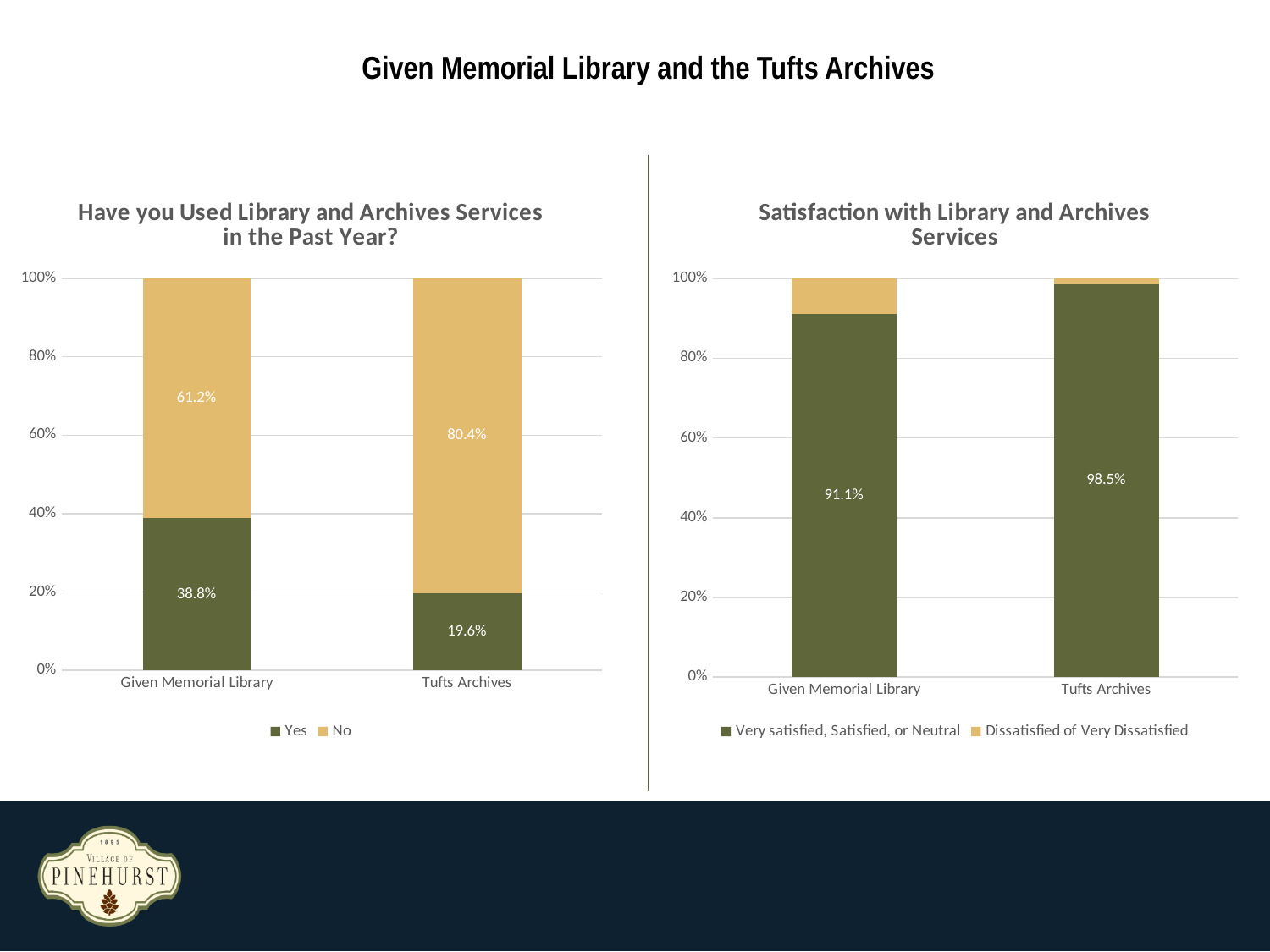
How many series does the legend of the 'Satisfaction with Library and Archives Services' chart list? 2 In the 'Have you Used Library and Archives Services in the Past Year?' chart, which category has the higher Yes value? Given Memorial Library In the 'Satisfaction with Library and Archives Services' chart, what is the difference between the 'Very satisfied, Satisfied, or Neutral' values for Tufts Archives and Given Memorial Library? 7.4% In the 'Have you Used Library and Archives Services in the Past Year?' chart, what is the difference between the Yes values for Given Memorial Library and Tufts Archives? 19.2% How many categories are shown on the x axis of the 'Have you Used Library and Archives Services in the Past Year?' chart? 2 In the 'Satisfaction with Library and Archives Services' chart, is the 'Dissatisfied of Very Dissatisfied' value for Given Memorial Library greater or less than 20%? less In the 'Satisfaction with Library and Archives Services' chart, what is the 'Very satisfied, Satisfied, or Neutral' value for Tufts Archives? 98.5% In the 'Have you Used Library and Archives Services in the Past Year?' chart, what is the No value for Given Memorial Library? 61.2% In the 'Satisfaction with Library and Archives Services' chart, what is the 'Very satisfied, Satisfied, or Neutral' value for Given Memorial Library? 91.1% In the 'Have you Used Library and Archives Services in the Past Year?' chart, what is the No value for Tufts Archives? 80.4% What kind of chart is the 'Satisfaction with Library and Archives Services' chart? Stacked bar chart In the 'Have you Used Library and Archives Services in the Past Year?' chart, what is the Yes value for Given Memorial Library? 38.8%